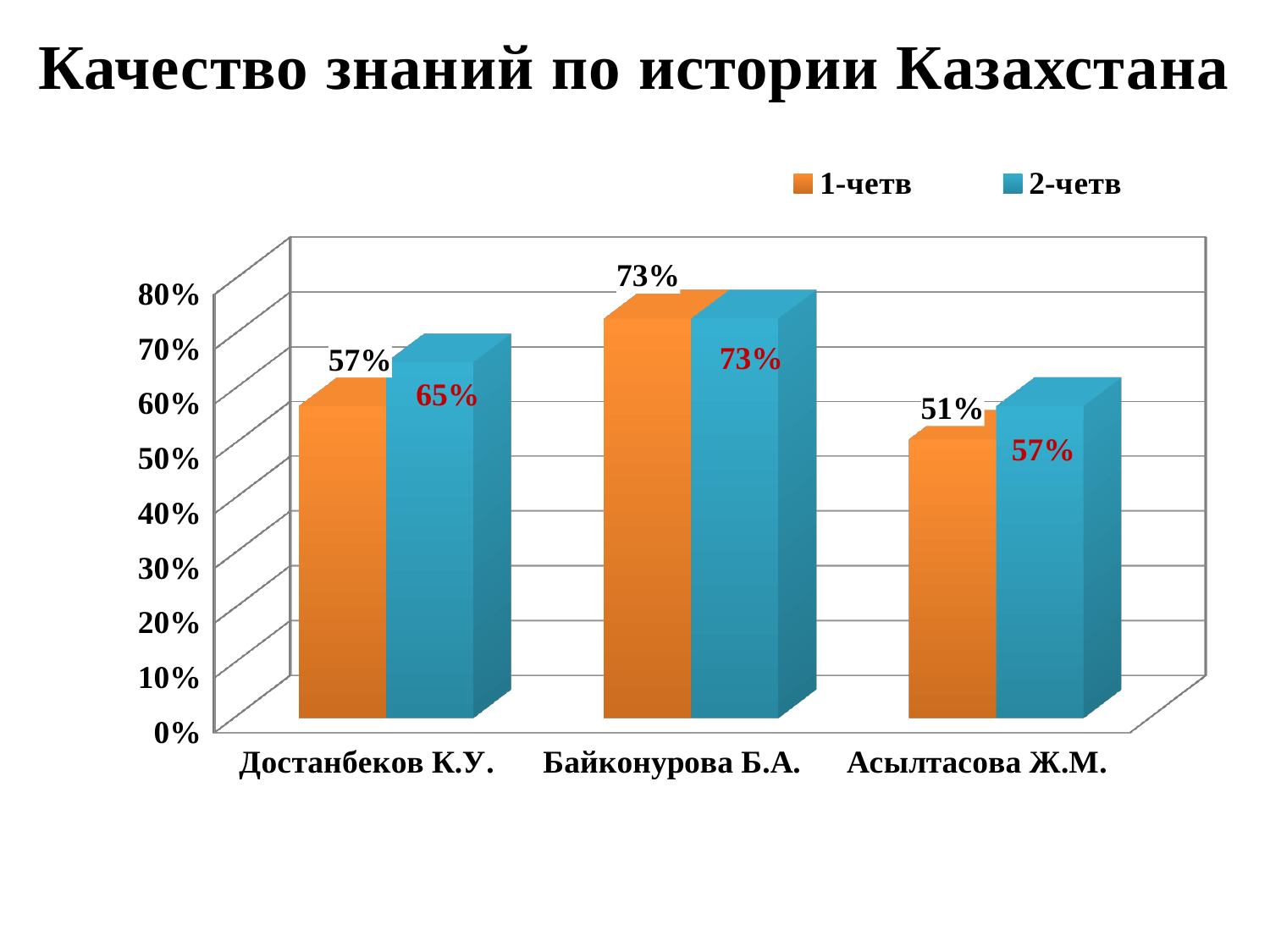
What is the difference between the 2-четв and 1-четв values for Достанбеков К.У.? 8% Which category has the highest 1-четв value? Байконурова Б.А. What is the title of the slide? Качество знаний по истории Казахстана How many categories are shown on the x axis? 3 How many series does the legend list? 2 What is the 1-четв value for Асылтасова Ж.М.? 51% What kind of chart is shown on the slide? Bar chart Which category has the lowest 2-четв value? Асылтасова Ж.М. Which is larger for Асылтасова Ж.М.: the 1-четв value or the 2-четв value? 2-четв What is the 1-четв value for Достанбеков К.У.? 57% What is the 2-четв value for Достанбеков К.У.? 65% What is the 2-четв value for Байконурова Б.А.? 73%